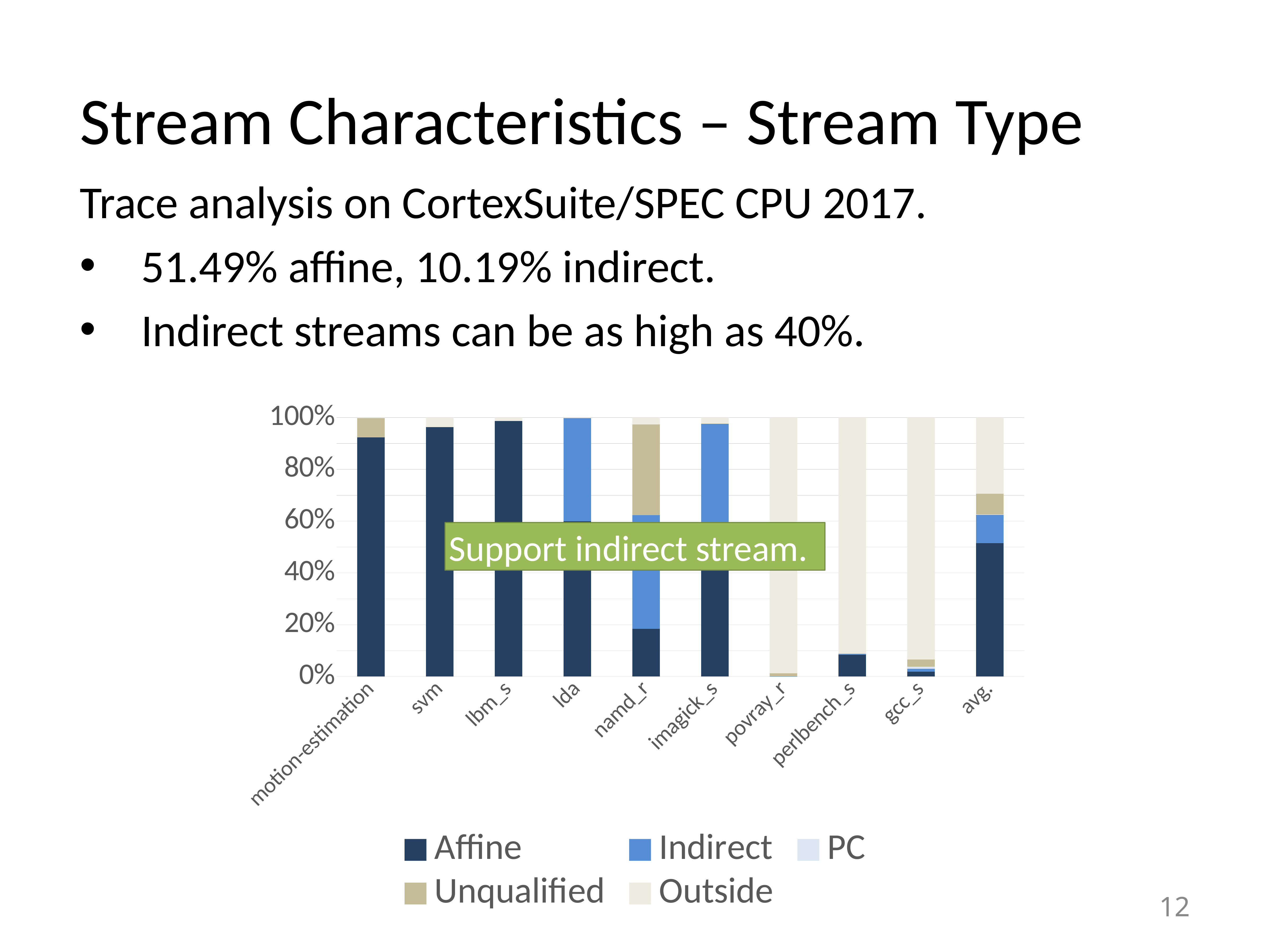
Is the Affine value for namd_r greater or less than 40%? less Is the Outside value for povray_r greater or less than 80%? greater How many categories are shown along the x axis of the chart? 10 Which series in the legend is shown in the darkest blue colour? Affine Which has the larger Indirect share, lda or avg.? lda Is the Affine value for motion-estimation greater or less than 80%? greater Which has the larger Affine share, motion-estimation or perlbench_s? motion-estimation How many series does the chart's legend list? 5 What text is shown in the green annotation box over the chart? Support indirect stream. What kind of chart is shown on the slide? stacked bar chart